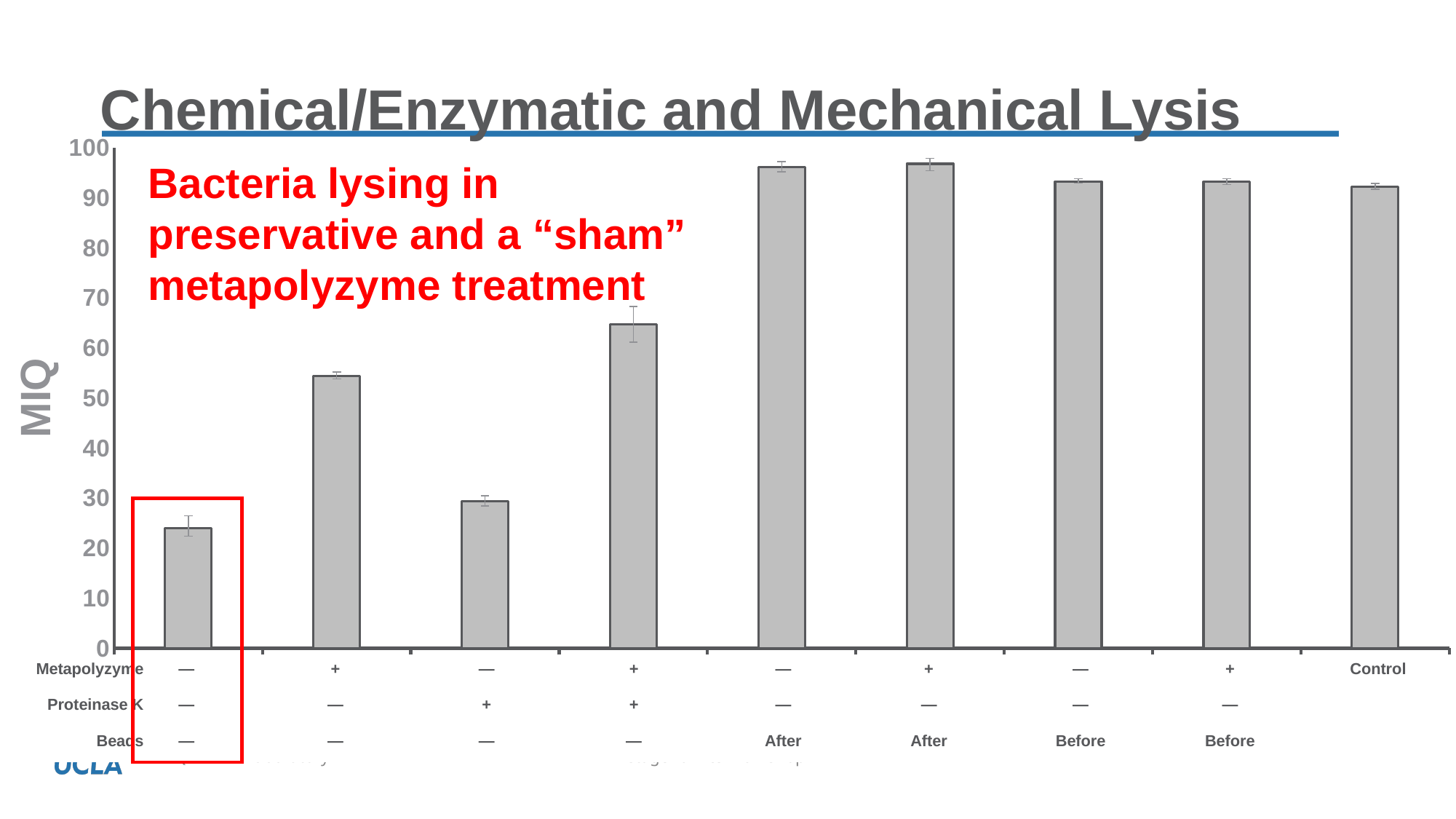
What is the label on the y axis of the chart? MIQ What is the title of the slide containing the chart? Chemical/Enzymatic and Mechanical Lysis Which has the higher MIQ value: the bar with Metapolyzyme + and Proteinase K − (no beads), or the bar with Metapolyzyme − and Proteinase K + (no beads)? Metapolyzyme +, Proteinase K − How many bars are plotted in the chart? 9 What kind of chart is shown on the slide? bar chart Is the MIQ value for the bar with Metapolyzyme +, Proteinase K +, Beads − greater or less than 60? greater Is the MIQ value for the bar with Metapolyzyme +, Proteinase K −, Beads − greater or less than 50? greater Which bar has the lowest MIQ value? Metapolyzyme −, Proteinase K −, Beads − (the first bar) Which has the higher MIQ value: the Control bar or the bar with Metapolyzyme +, Proteinase K +, Beads −? Control Is the MIQ value for the bar with Metapolyzyme −, Proteinase K +, Beads − greater or less than 40? less